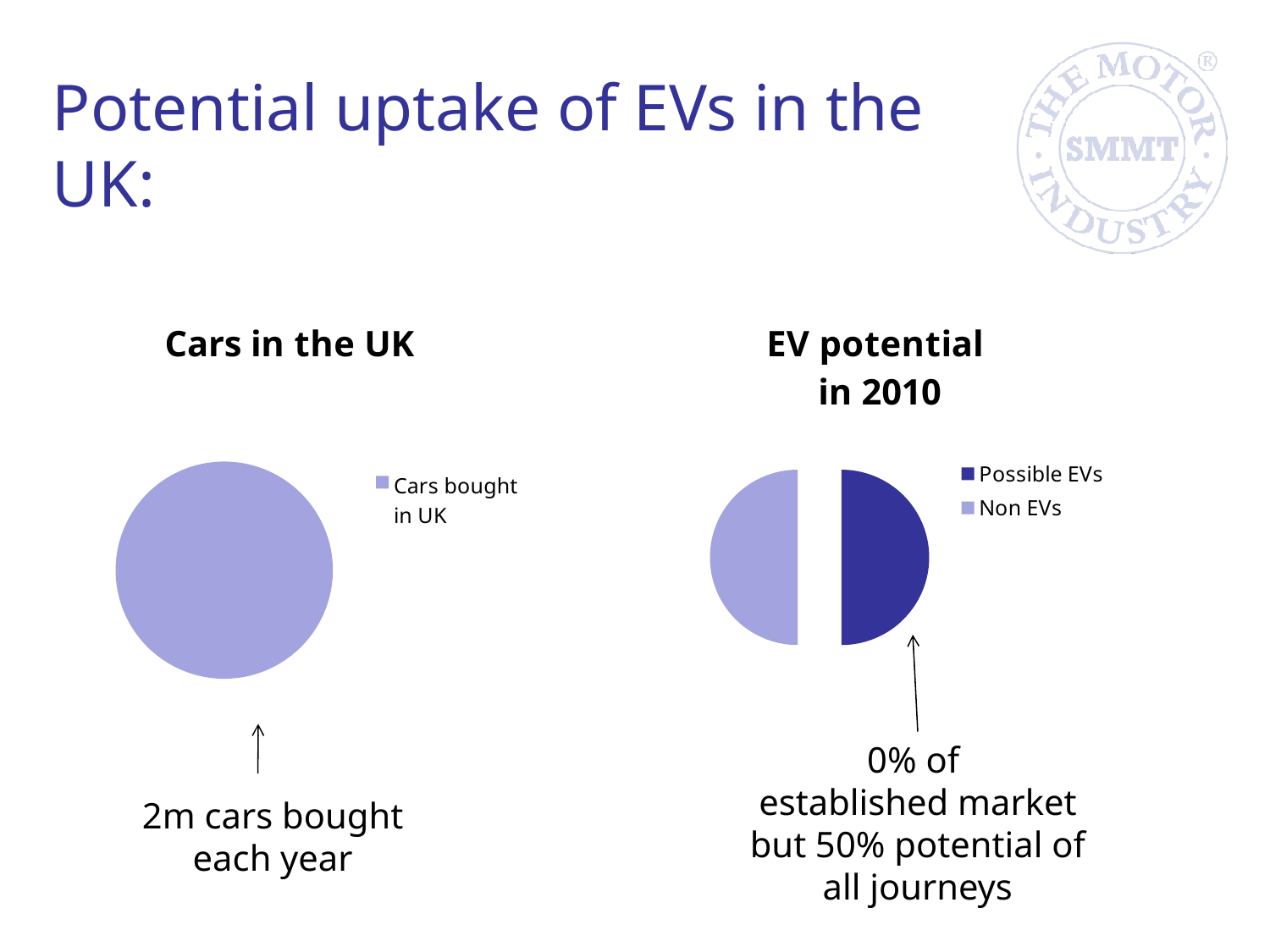
How many slices does the "Cars in the UK" pie chart have? 1 What are the two legend entries of the "EV potential in 2010" chart? Possible EVs and Non EVs How many slices does the "EV potential in 2010" pie chart have? 2 What is the title of the pie chart on the left of the slide? Cars in the UK How many entries does the legend of the "Cars in the UK" chart list? 1 What kind of chart is the "Cars in the UK" chart? Pie chart In the "EV potential in 2010" chart, what share of the pie do Possible EVs represent? 50% What kind of chart is the "EV potential in 2010" chart? Pie chart How many entries does the legend of the "EV potential in 2010" chart list? 2